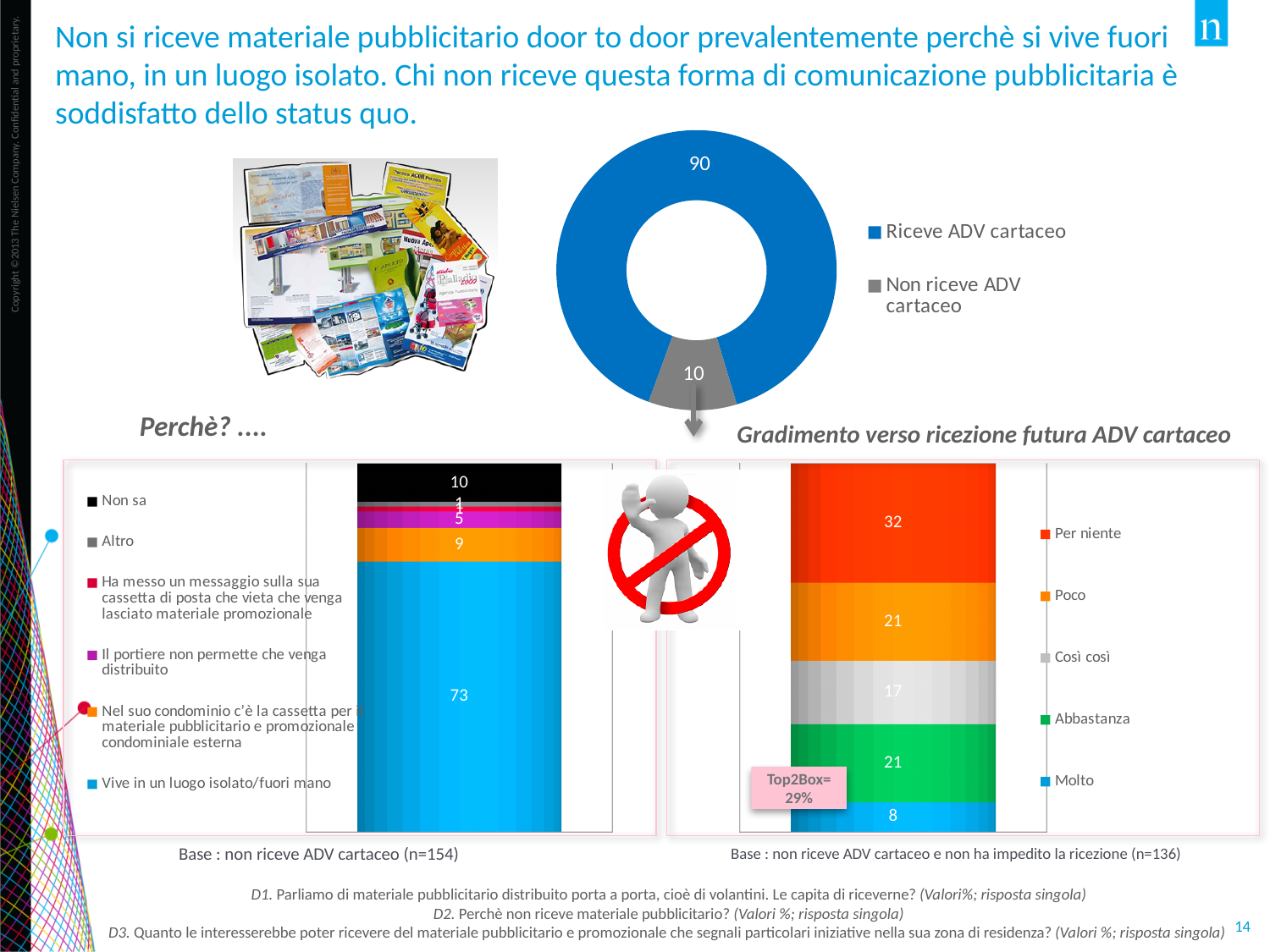
How many entries does the legend of the doughnut chart at the top of the slide list? 2 In the doughnut chart at the top of the slide, what value is shown for 'Riceve ADV cartaceo'? 90 In the 'Perchè? ....' chart, what value is shown for 'Nel suo condominio c'è la cassetta per il materiale pubblicitario e promozionale condominiale esterna'? 9 In the 'Perchè? ....' chart, which category has the highest value? Vive in un luogo isolato/fuori mano In the 'Gradimento verso ricezione futura ADV cartaceo' chart, which category has the lowest value? Molto In the 'Perchè? ....' chart, what value is shown for 'Non sa'? 10 In the doughnut chart at the top of the slide, what value is shown for 'Non riceve ADV cartaceo'? 10 In the 'Perchè? ....' chart, what value is shown for 'Vive in un luogo isolato/fuori mano'? 73 How many entries does the legend of the 'Perchè? ....' chart list? 6 In the 'Gradimento verso ricezione futura ADV cartaceo' chart, what is the difference between the values for 'Per niente' and 'Poco'? 11 In the 'Gradimento verso ricezione futura ADV cartaceo' chart, what value is shown for 'Per niente'? 32 What kind of chart is the 'Gradimento verso ricezione futura ADV cartaceo' chart? Stacked bar chart